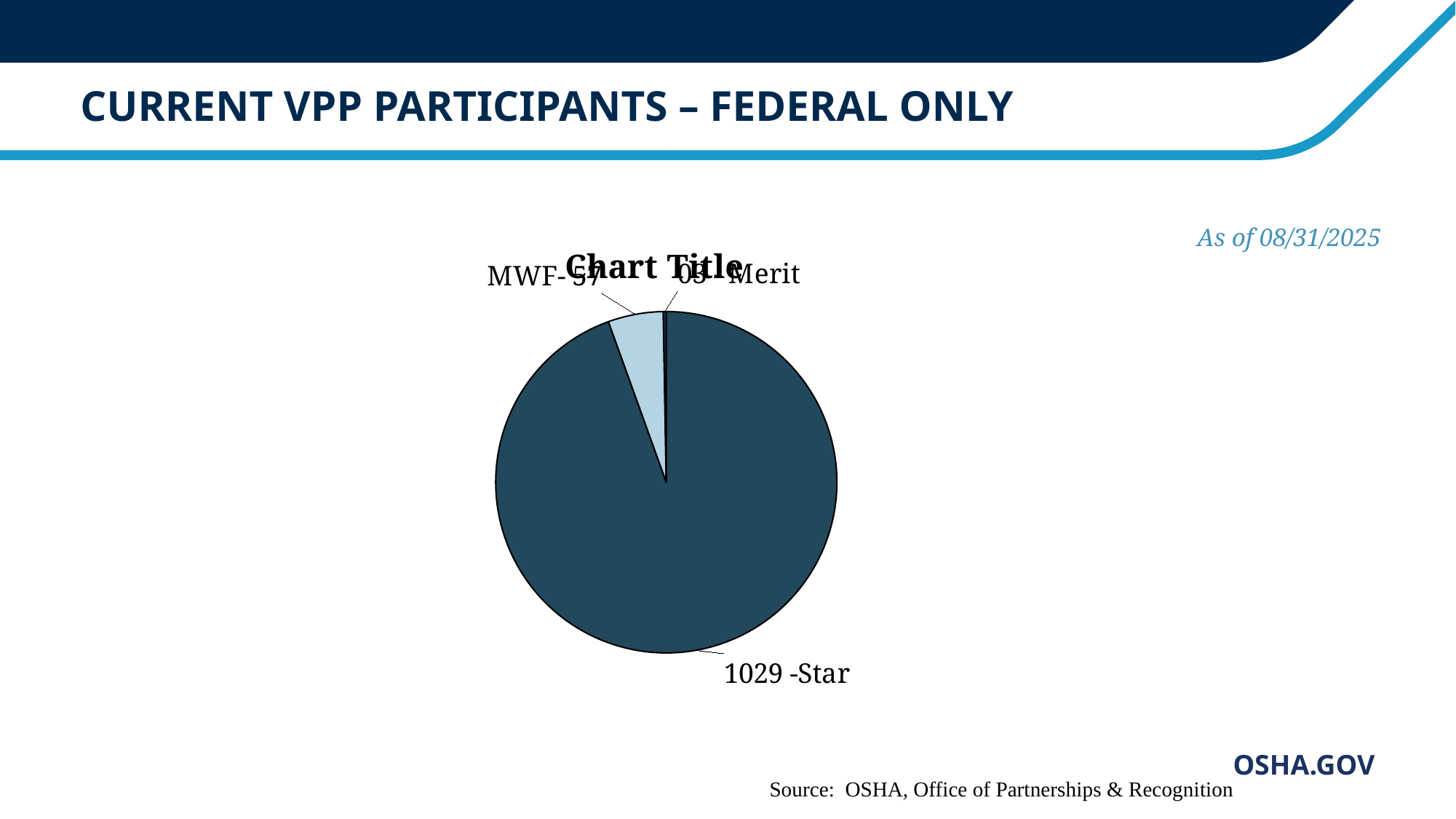
Which category has the largest slice of the pie chart? Star Which slice of the pie chart is shown in light blue? MWF Which slice is larger, Star or MWF? Star What is the title printed above the pie chart? Chart Title Which category has the smallest slice of the pie chart? Merit Which slice is larger, MWF or Merit? MWF What is the value shown for the Star slice of the pie chart? 1029 How many slices does the pie chart have? 3 What kind of chart is shown on the slide? pie chart